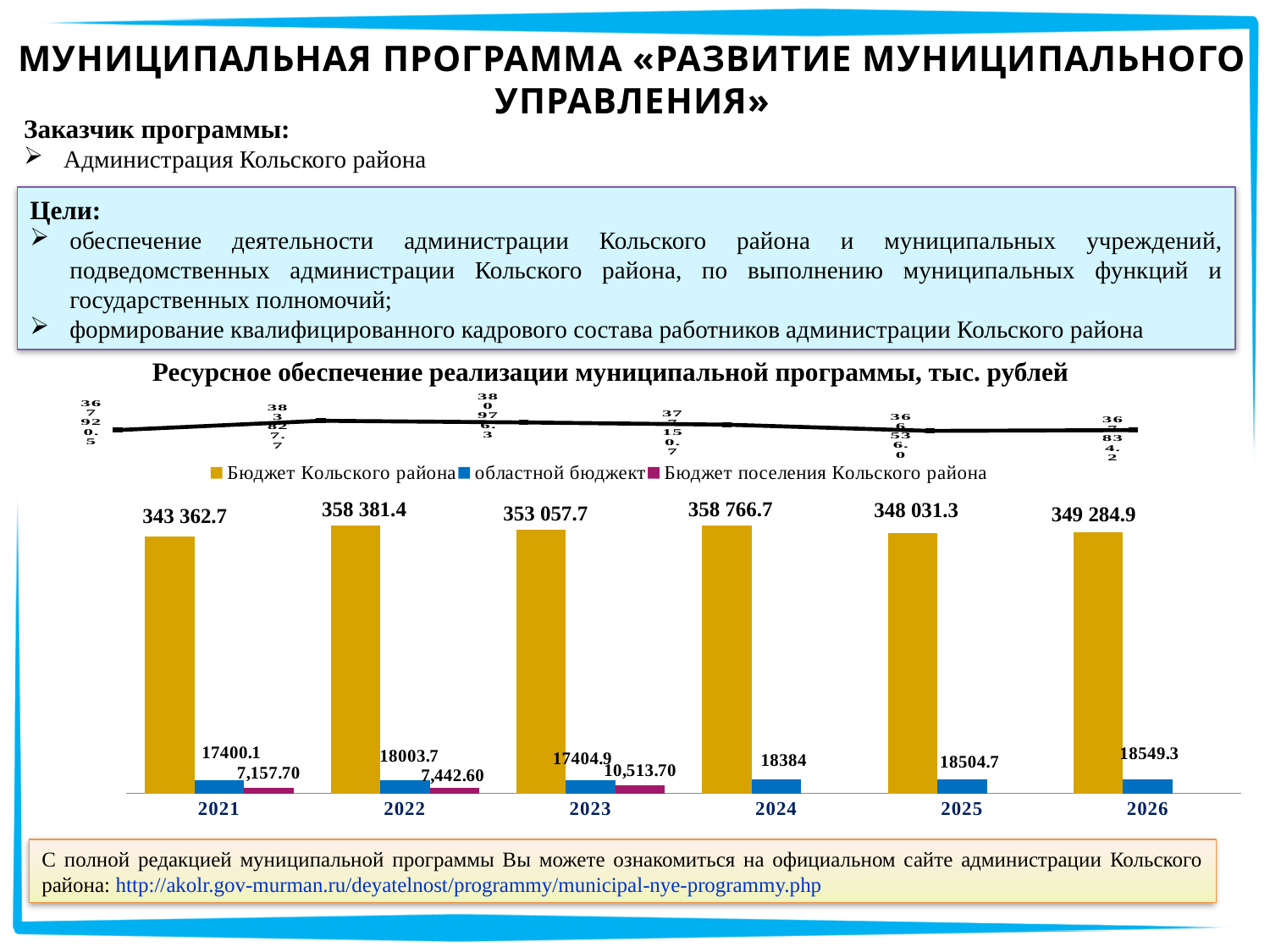
Which is larger: Бюджет Кольского района in 2025 or in 2026? 2026 In which year is Бюджет Кольского района the lowest? 2021 What is the value of Бюджет Кольского района for 2021? 343 362.7 Does Бюджет поселения Кольского района rise or fall from 2021 to 2023? rise What is the difference between областной бюджет in 2024 and in 2021? 983.9 How many series does the legend of the bar chart list? 3 What kind of chart shows the budget values by year? bar chart In which year is Бюджет Кольского района the highest? 2024 In which year is областной бюджет the highest? 2026 What is the value of областной бюджет for 2024? 18384 What is the value of Бюджет поселения Кольского района for 2023? 10,513.70 How many years are shown on the x axis of the bar chart? 6